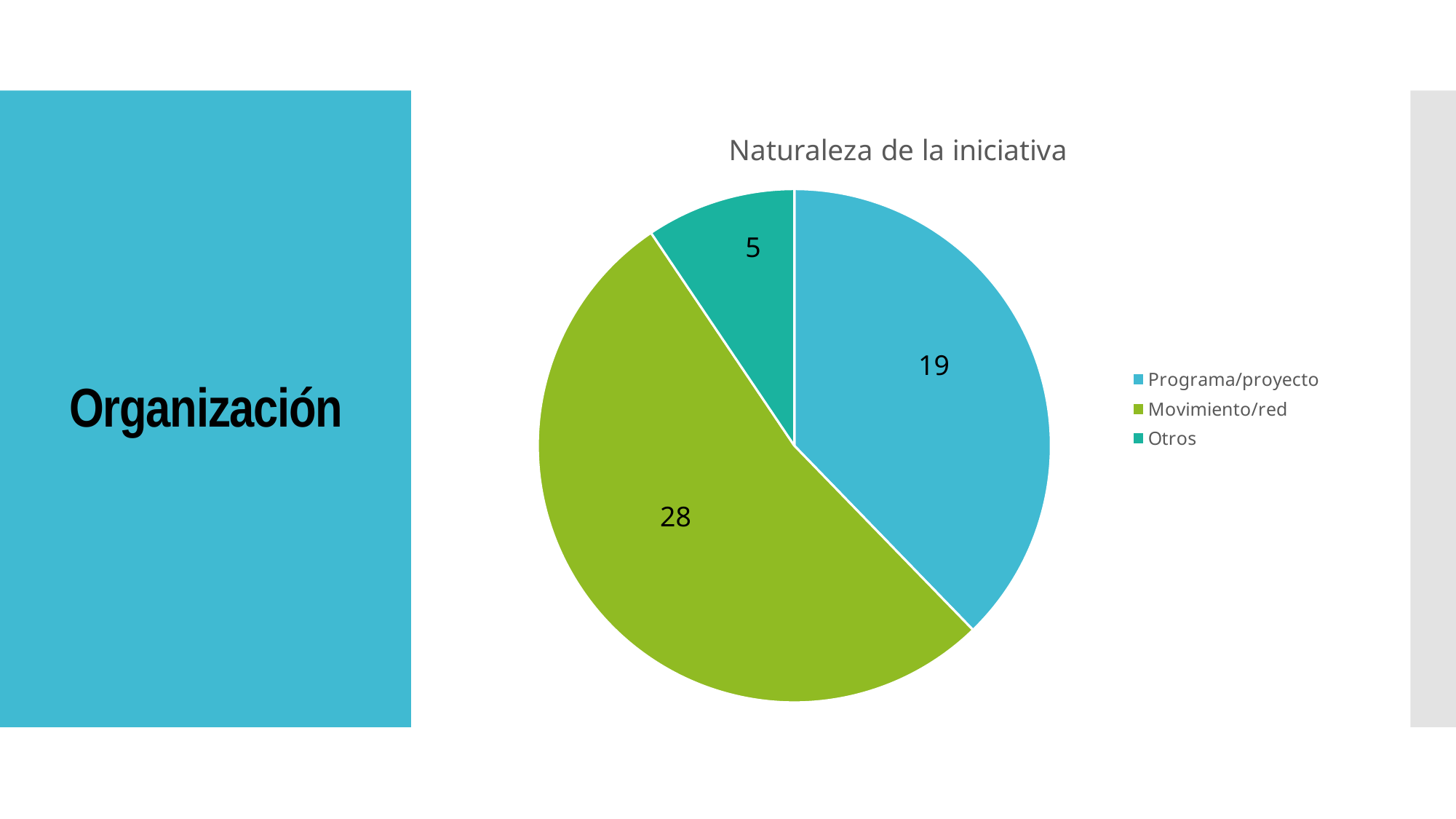
What is the value for Movimiento/red? 28 What kind of chart is shown on the slide? Pie chart What is the difference between the values for Movimiento/red and Programa/proyecto? 9 What is the title of the chart? Naturaleza de la iniciativa Which category has the largest slice? Movimiento/red What is the value for Otros? 5 What colour is the Movimiento/red slice? Green What is the value for Programa/proyecto? 19 How many categories does the pie chart show? 3 Which is larger, Programa/proyecto or Otros? Programa/proyecto Which category has the smallest slice? Otros What is the total of all slices in the pie chart? 52